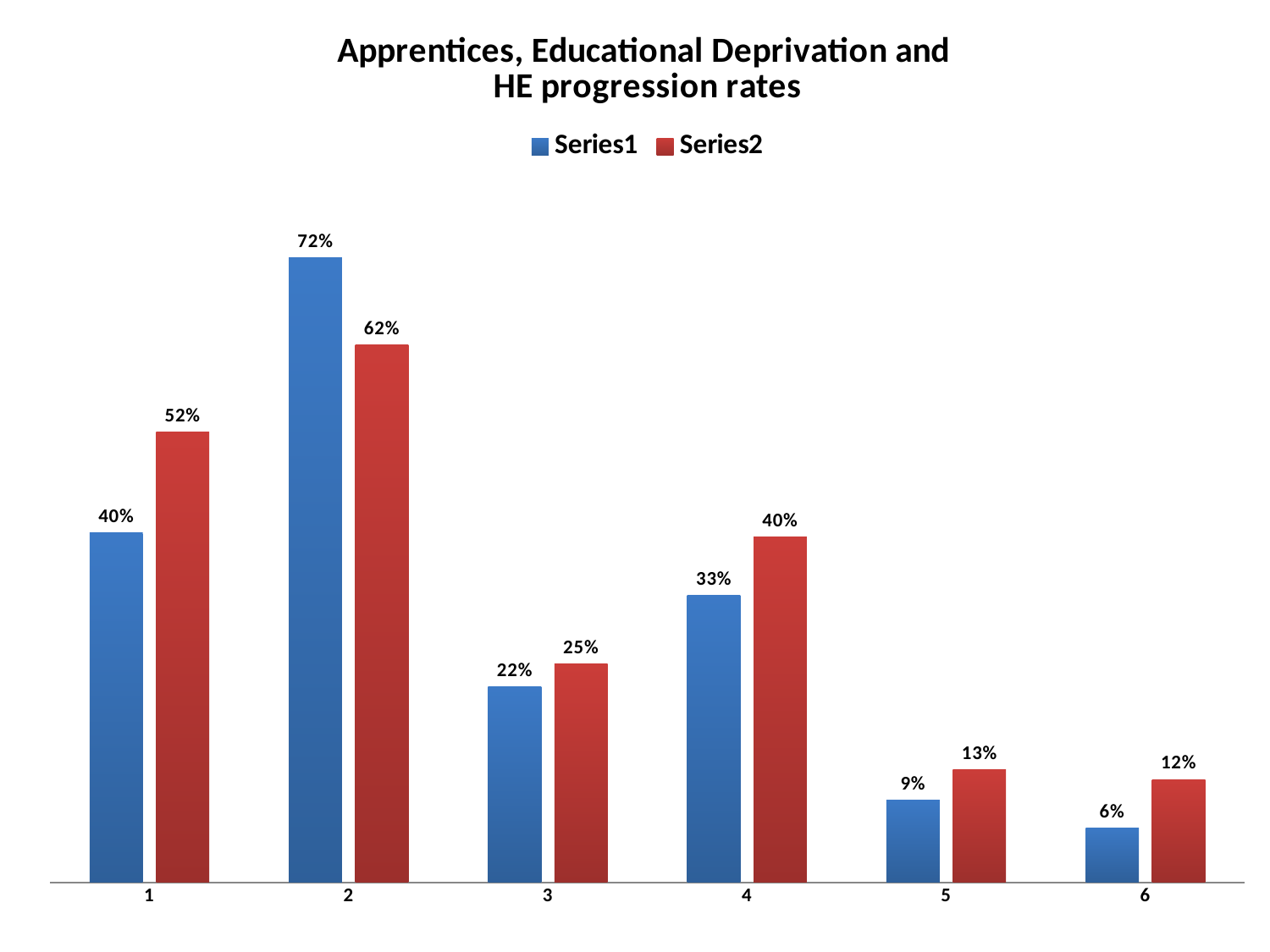
For category 4, which series has the larger value? Series2 What is the value of Series2 for category 5? 13% Which category has the lowest Series2 value? 6 Which category has the highest Series1 value? 2 What kind of chart is shown on the slide? Bar chart What is the value of Series2 for category 1? 52% How many categories are shown on the x axis? 6 How many series does the legend list? 2 What is the title of the chart? Apprentices, Educational Deprivation and HE progression rates What is the difference between Series2 and Series1 for category 1? 12% What is the value of Series1 for category 2? 72% What is the difference between Series1 and Series2 for category 2? 10%